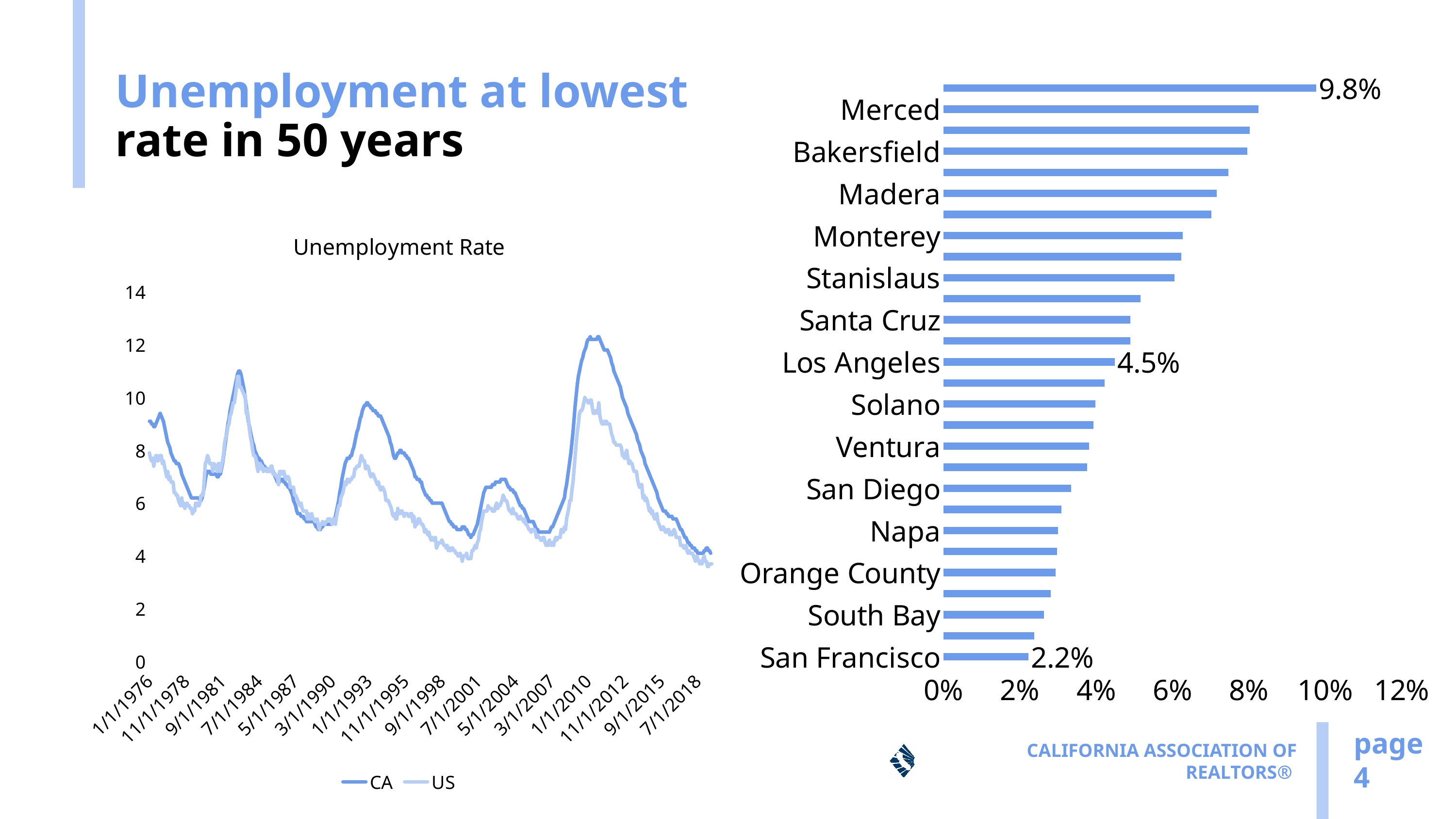
In the Unemployment Rate chart on the left, which series is higher at 1/1/2010, CA or US? CA In the bar chart on the right, is the value for Madera greater or less than 6%? greater In the bar chart on the right, which has the larger value, Merced or San Diego? Merced In the bar chart on the right, is the value for San Diego greater or less than 4%? less In the bar chart on the right, what is the value labeled on the longest bar? 9.8% What kind of chart is the Unemployment Rate chart on the left? line chart In the bar chart on the right, what is the value shown for Los Angeles? 4.5% In the bar chart on the right, what is the value shown for San Francisco? 2.2% In the Unemployment Rate chart on the left, how many series does the legend list? 2 In the bar chart on the right, which labeled county has the shortest bar? San Francisco In the bar chart on the right, what is the difference between the values for Los Angeles and San Francisco? 2.3% In the Unemployment Rate chart on the left, does the CA line rise or fall between 1/1/2010 and 7/1/2018? fall